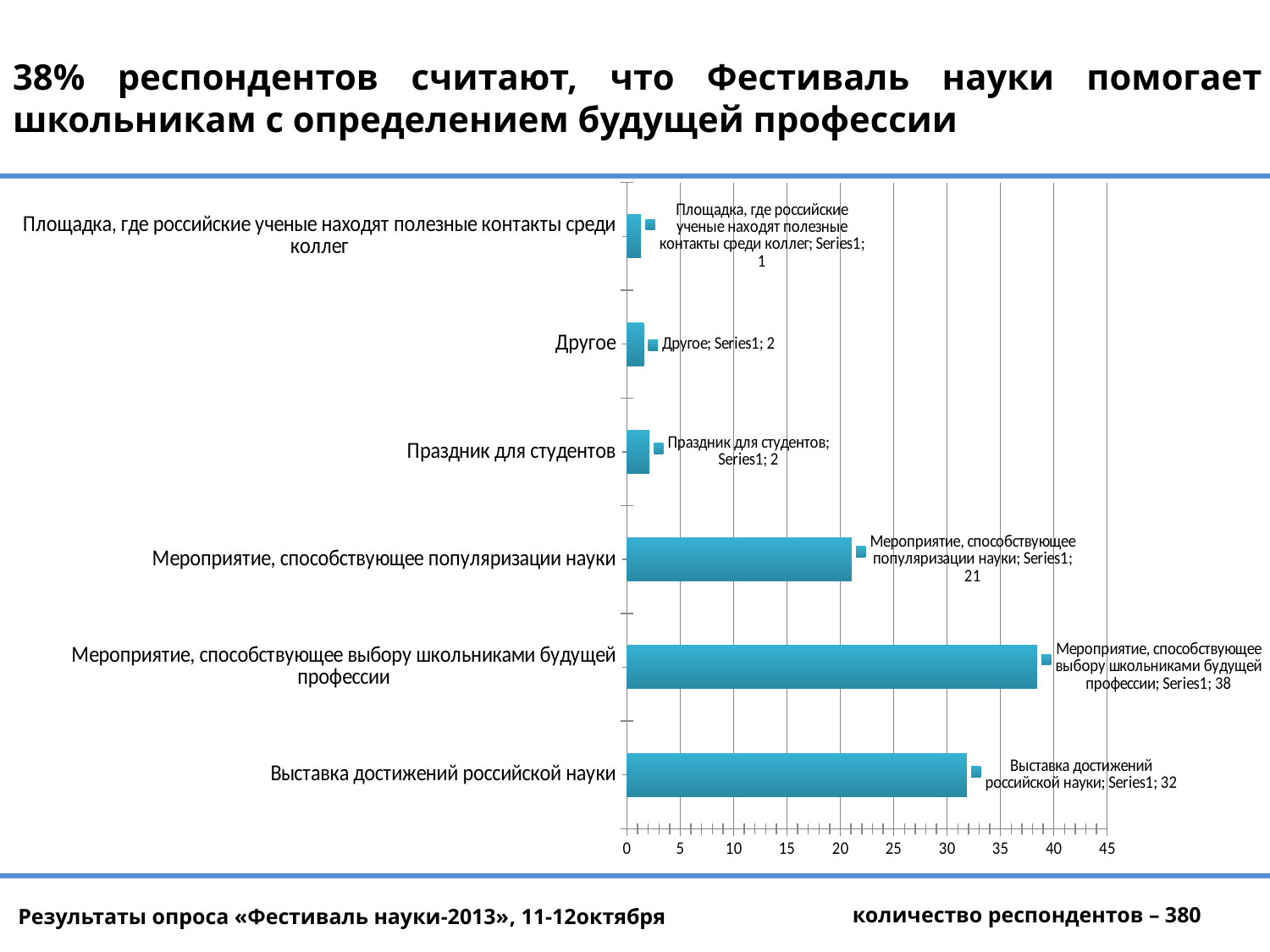
What is the maximum value shown on the horizontal axis? 45 Is the value for "Мероприятие, способствующее популяризации науки" greater or less than 25? less How many categories are shown in the chart? 6 What is the value for "Мероприятие, способствующее выбору школьниками будущей профессии"? 38 Which is larger: the value for "Выставка достижений российской науки" or for "Мероприятие, способствующее популяризации науки"? Выставка достижений российской науки What is the value for "Площадка, где российские ученые находят полезные контакты среди коллег"? 1 Which category has the highest value? Мероприятие, способствующее выбору школьниками будущей профессии What is the difference between the values for "Мероприятие, способствующее выбору школьниками будущей профессии" and "Выставка достижений российской науки"? 6 What is the value for "Мероприятие, способствующее популяризации науки"? 21 What is the value for "Выставка достижений российской науки"? 32 What kind of chart is shown on the slide? bar chart Which category has the lowest value? Площадка, где российские ученые находят полезные контакты среди коллег